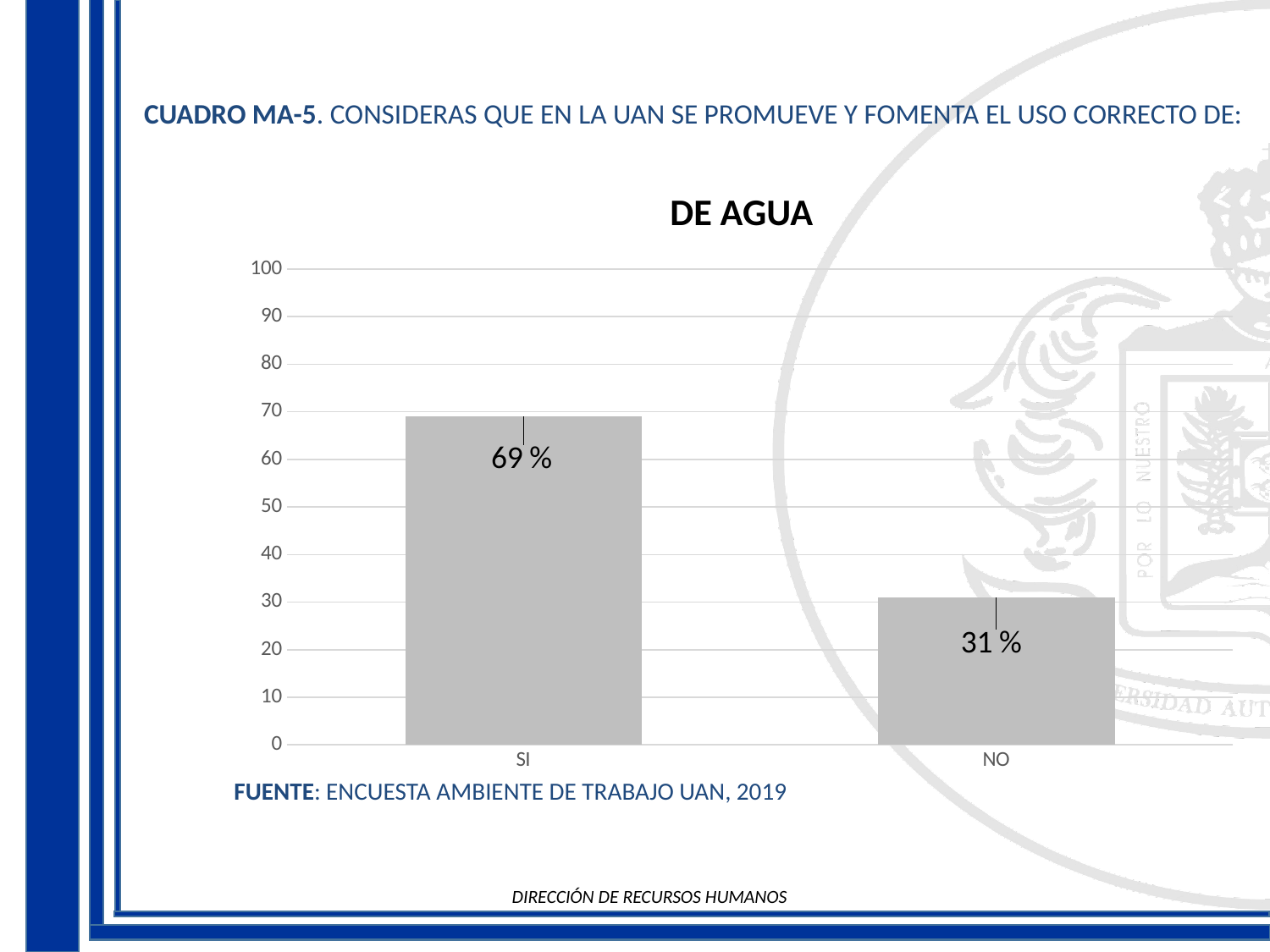
What is the title of the chart? DE AGUA Is the value for NO greater or less than 40? less Which is larger, the value for SI or the value for NO? SI Which category has the highest value? SI What is the highest value shown on the vertical axis? 100 Which category has the lowest value? NO What is the value for SI? 69 % What is the difference between the values for SI and NO? 38 % How many categories are shown on the x axis? 2 Is the value for SI greater or less than 60? greater What is the value for NO? 31 % What kind of chart is shown? bar chart